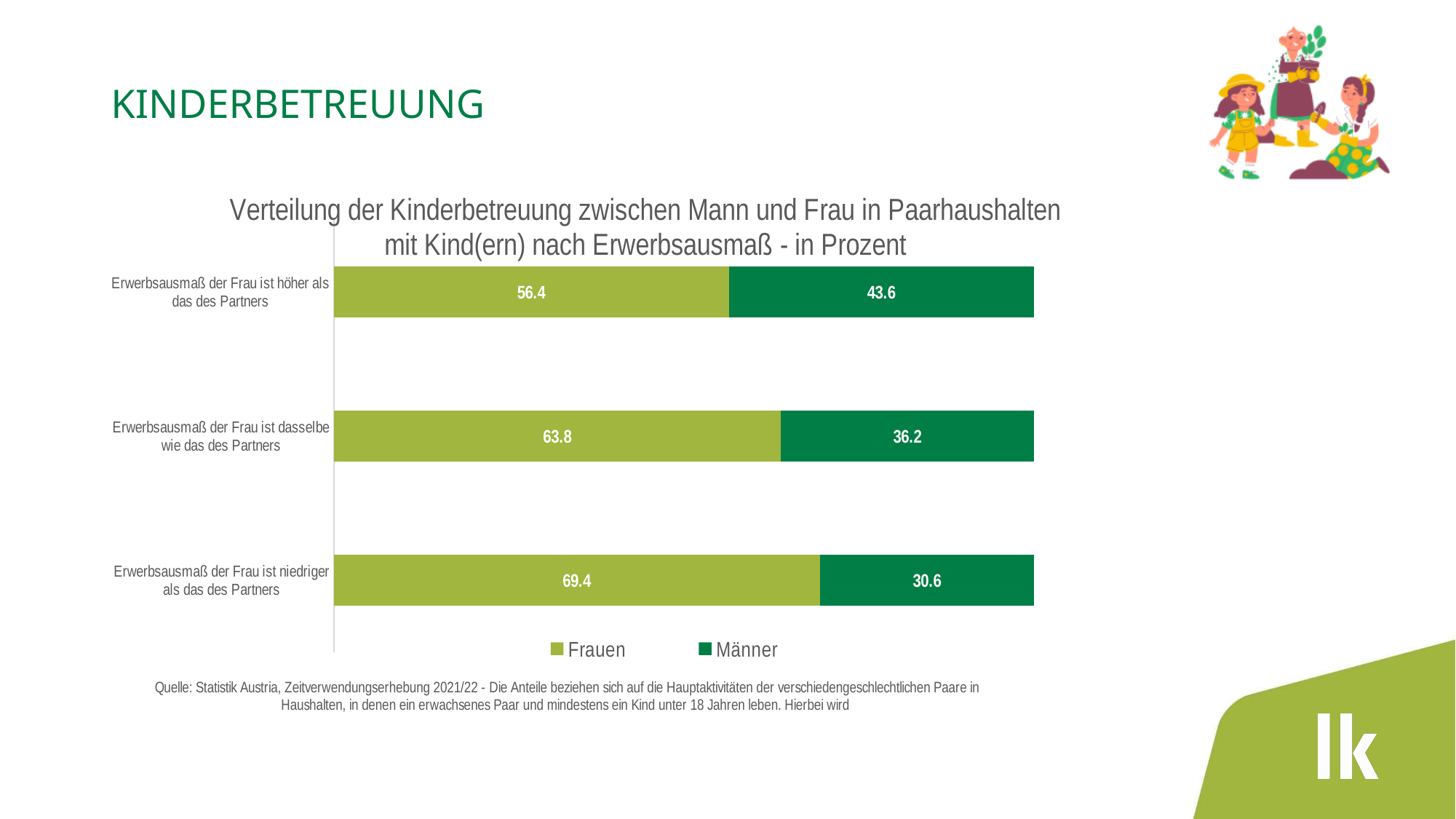
How many series does the legend list? 2 What is the difference between the Frauen and Männer values for 'Erwerbsausmaß der Frau ist höher als das des Partners'? 12.8 What is the Männer value for 'Erwerbsausmaß der Frau ist niedriger als das des Partners'? 30.6 How many categories are shown in the chart? 3 What is the Frauen value for 'Erwerbsausmaß der Frau ist höher als das des Partners'? 56.4 Which category has the highest Frauen value? Erwerbsausmaß der Frau ist niedriger als das des Partners What is the Männer value for 'Erwerbsausmaß der Frau ist dasselbe wie das des Partners'? 36.2 Which is larger: the Männer value for 'Erwerbsausmaß der Frau ist höher als das des Partners' or the Männer value for 'Erwerbsausmaß der Frau ist dasselbe wie das des Partners'? Erwerbsausmaß der Frau ist höher als das des Partners What is the Frauen value for 'Erwerbsausmaß der Frau ist niedriger als das des Partners'? 69.4 What kind of chart is shown on the slide? Stacked bar chart Which category has the lowest Männer value? Erwerbsausmaß der Frau ist niedriger als das des Partners What is the total of the stacked bar for 'Erwerbsausmaß der Frau ist dasselbe wie das des Partners'? 100